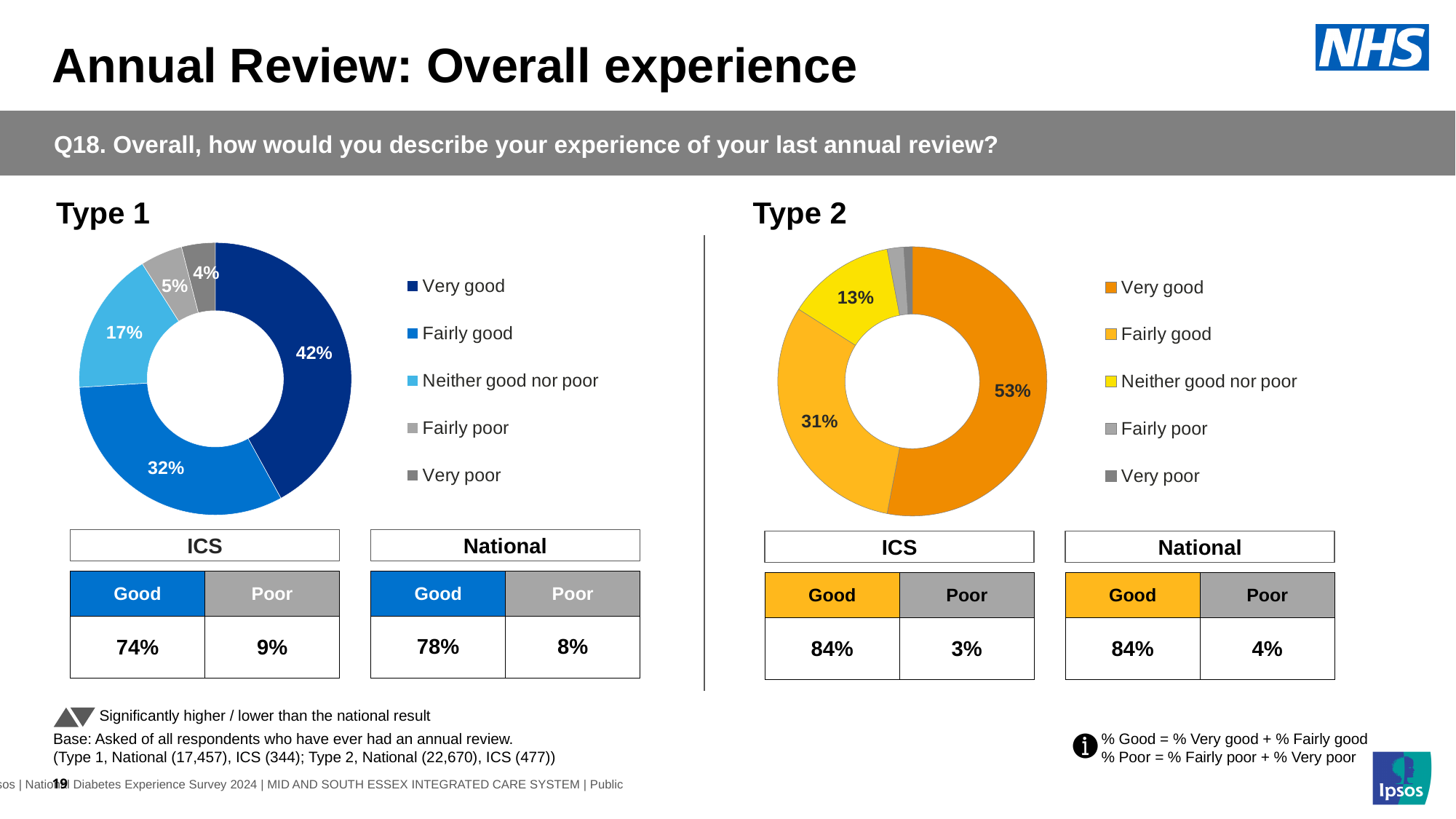
In the Type 2 chart, what is the difference between the Very good and Neither good nor poor shares? 40 percentage points In the Type 1 chart, which category has the largest share? Very good In the Type 2 chart, what percentage of respondents said Very good? 53% In the Type 1 chart, which category has the smallest share? Very poor In the Type 1 chart, what percentage said Neither good nor poor? 17% What type of chart is used for Type 1? Donut (pie) chart Is the Very good share larger in the Type 1 chart or the Type 2 chart? Type 2 In the Type 2 chart, which category has the largest share? Very good In the Type 1 chart, what is the difference between the Very good and Fairly good shares? 10 percentage points In the Type 1 chart, what percentage of respondents said their experience was Very good? 42% How many categories does the legend of the Type 2 chart list? 5 In the Type 2 chart, what percentage said Fairly good? 31%